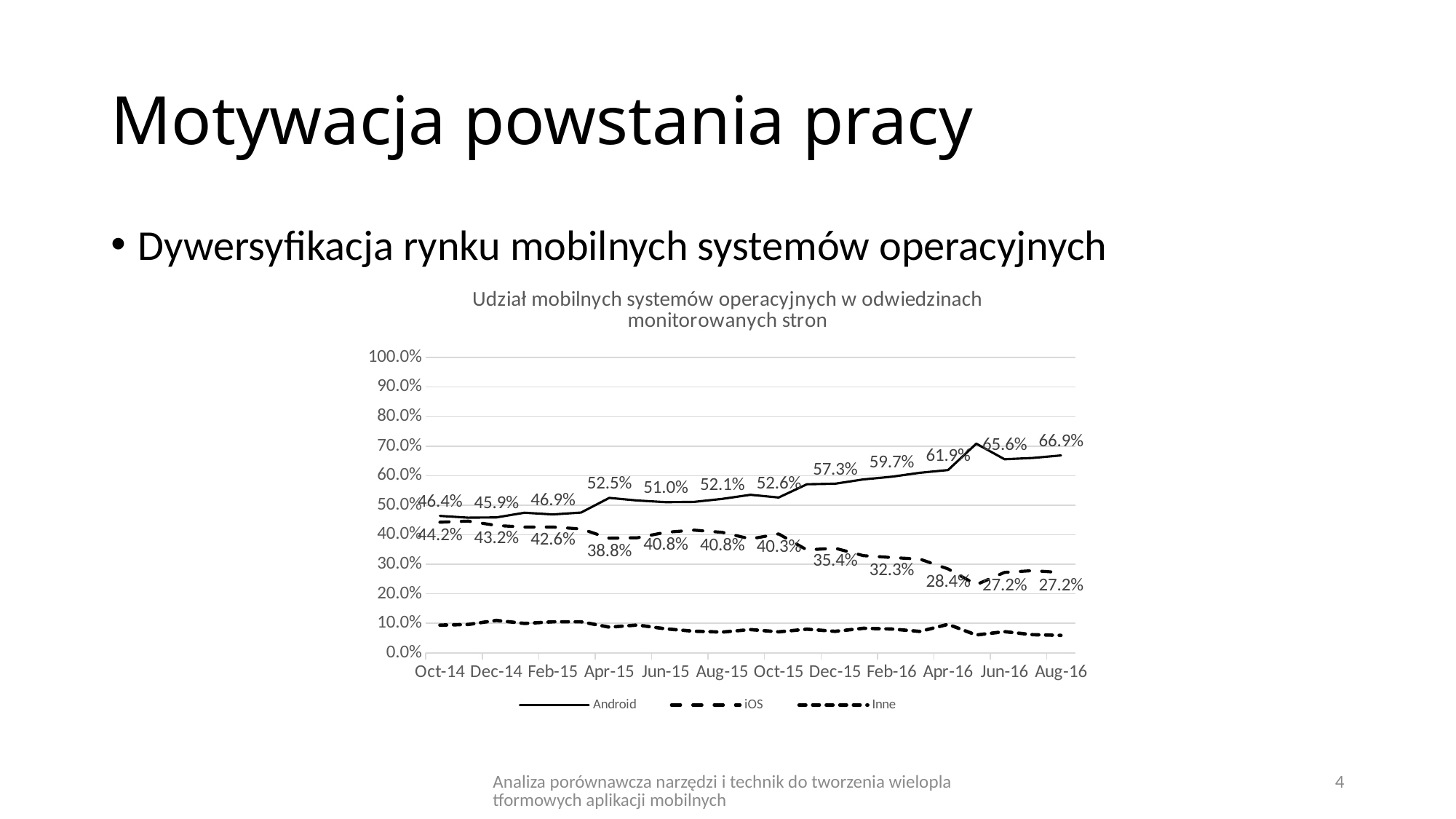
What is the difference between the Android and iOS shares in Aug-16? 39.7% What is the Android share in Apr-15? 52.5% What type of chart is shown on the slide? line chart How many series does the chart legend list? 3 Does the Android share rise or fall from Oct-14 to Aug-16? rise What is the iOS share in Feb-16? 32.3% What is the Android share in Aug-16? 66.9% Does the iOS share rise or fall from Oct-14 to Aug-16? fall Which series has the higher value in Oct-14, Android or iOS? Android Is the value for Inne in Aug-16 greater or less than 10.0%? less What is the iOS share in Oct-14? 44.2% What is the title of the chart? Udział mobilnych systemów operacyjnych w odwiedzinach monitorowanych stron